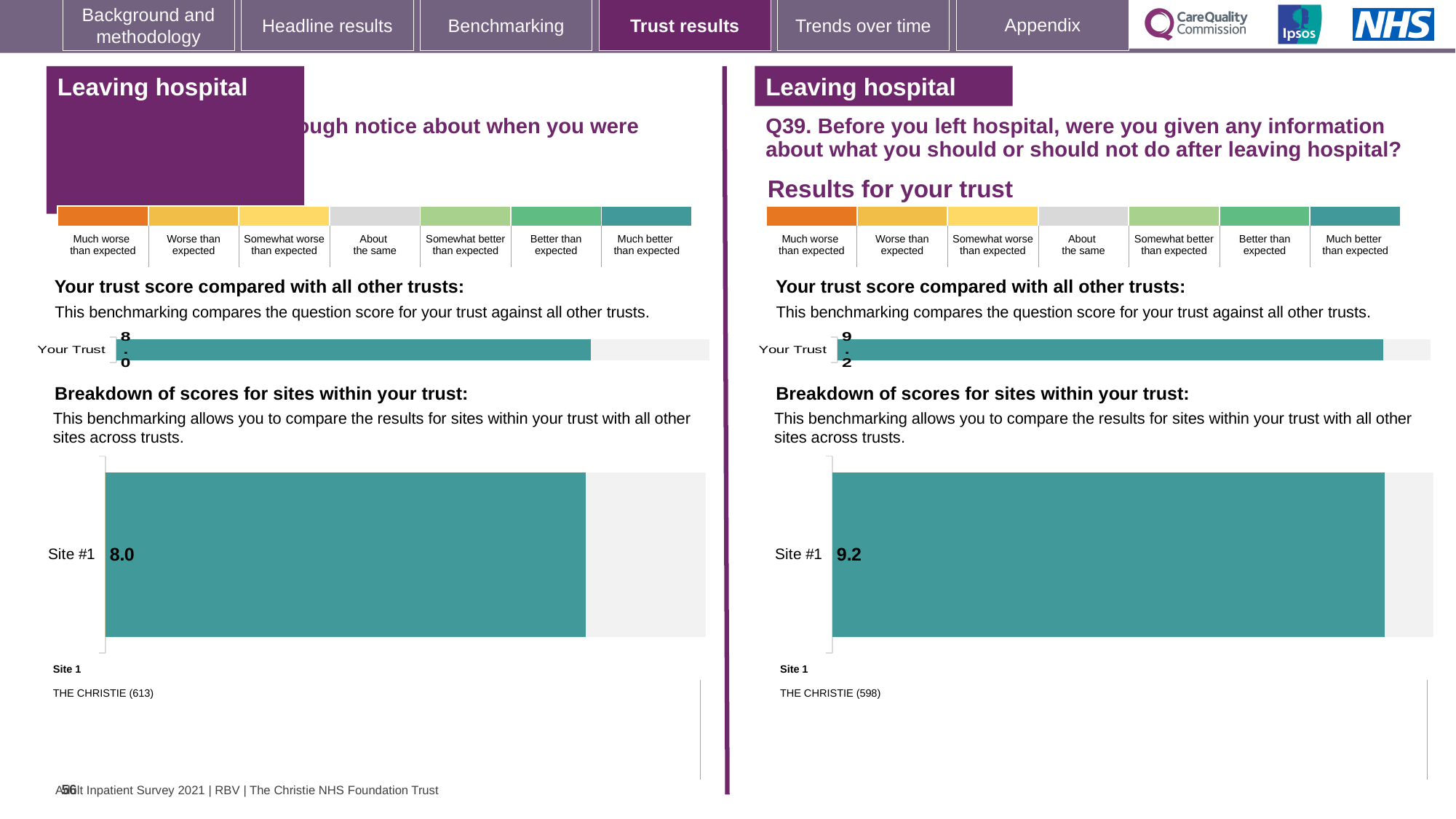
On the left panel, which site name is listed under Site 1 below the chart? THE CHRISTIE (613) How many sites are shown in the 'Breakdown of scores for sites within your trust' chart on the left panel? 1 On the right panel (Q39), what is the score shown for Your Trust in the 'Your trust score compared with all other trusts' chart? 9.2 How many sites are shown in the 'Breakdown of scores for sites within your trust' chart on the right panel (Q39)? 1 On the left panel, what score is shown for Site #1 in the 'Breakdown of scores for sites within your trust' chart? 8.0 On the left panel, what is the score shown for Your Trust in the 'Your trust score compared with all other trusts' chart? 8.0 On the right panel (Q39), what score is shown for Site #1 in the 'Breakdown of scores for sites within your trust' chart? 9.2 What is the difference between the Site #1 score on the right panel (Q39) and the Site #1 score on the left panel? 1.2 What kind of chart is used to show the Site #1 score on the right panel (Q39)? Bar chart Is the Your Trust score on the left panel greater or less than 9? less On the right panel (Q39), which site name is listed under Site 1 below the chart? THE CHRISTIE (598) Which panel shows the higher Your Trust score: the left panel or the right panel (Q39)? Right panel (Q39)